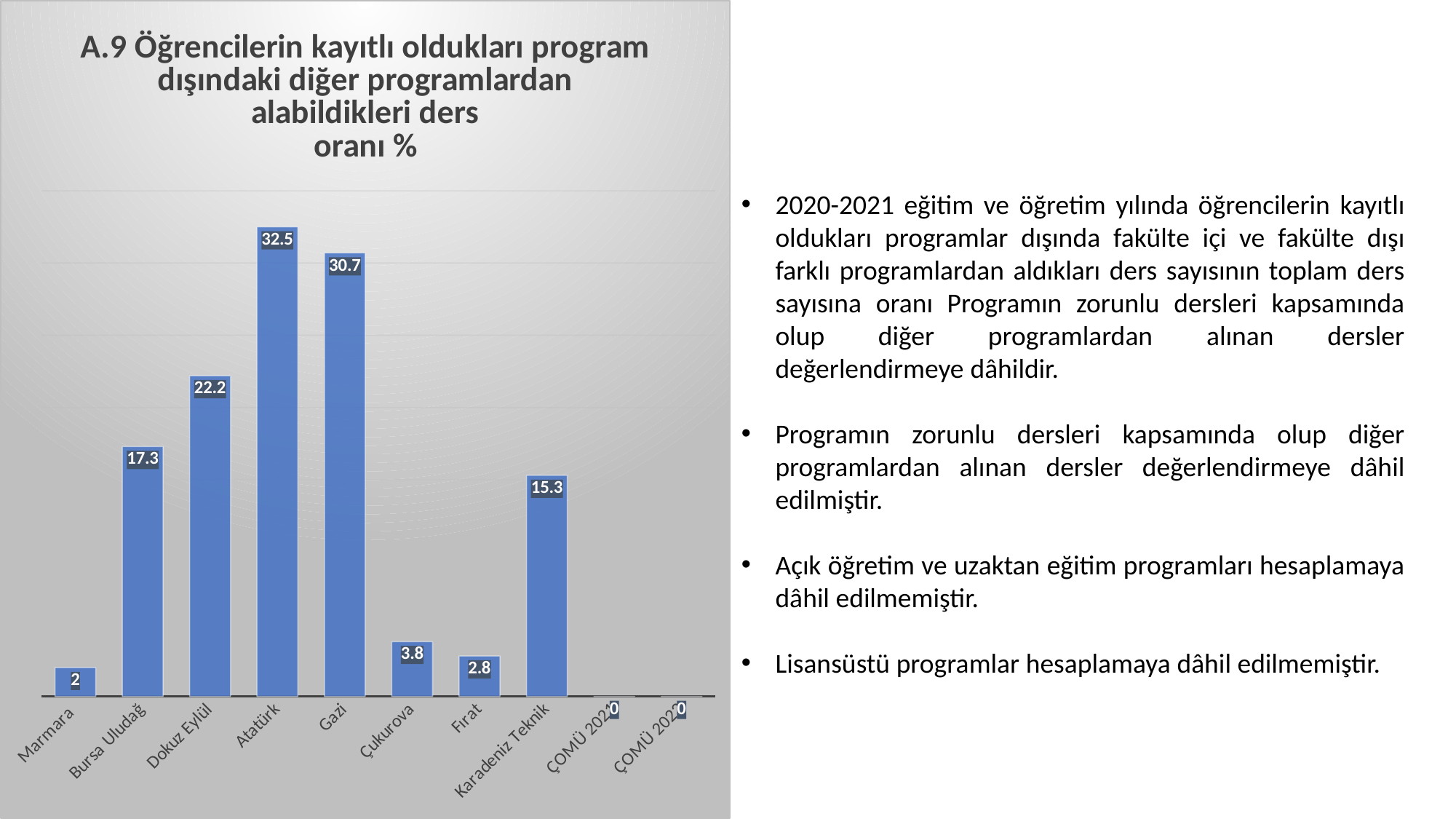
What type of chart is shown on the slide? bar chart Which is larger, the value for Çukurova or the value for Fırat? Çukurova How many categories are shown on the x axis? 10 What is the value for Gazi? 30.7 Which category has the highest value? Atatürk What is the value for Bursa Uludağ? 17.3 What is the value for Atatürk? 32.5 What is the difference between the values for Dokuz Eylül and Bursa Uludağ? 4.9 What is the value for Marmara? 2 What is the difference between the values for Atatürk and Gazi? 1.8 What is the value for Karadeniz Teknik? 15.3 What is the title of the chart? A.9 Öğrencilerin kayıtlı oldukları program dışındaki diğer programlardan alabildikleri ders oranı %